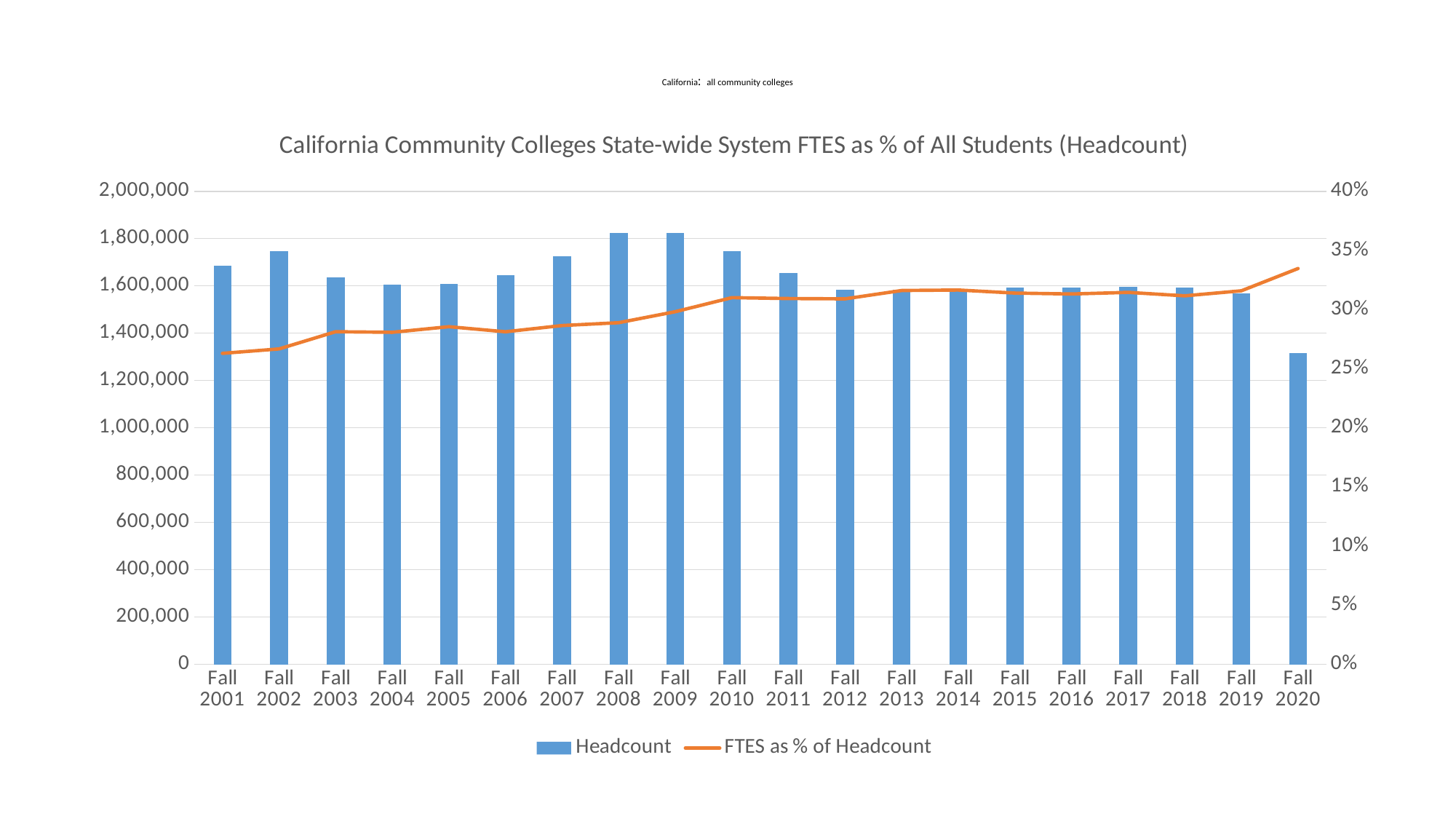
Which has the larger Headcount, Fall 2002 or Fall 2004? Fall 2002 In which Fall term is FTES as % of Headcount highest? Fall 2020 What kind of chart is shown on the slide? A combination bar and line chart Which Fall term has the lowest Headcount? Fall 2020 Is FTES as % of Headcount for Fall 2020 greater or less than 30%? greater Is FTES as % of Headcount for Fall 2001 greater or less than 30%? less Does FTES as % of Headcount generally rise or fall from Fall 2001 to Fall 2020? rise Is the Headcount for Fall 2020 greater or less than 1,400,000? less What is the title of the chart? California Community Colleges State-wide System FTES as % of All Students (Headcount) How many series does the legend list? 2 How many Fall terms are shown on the x axis? 20